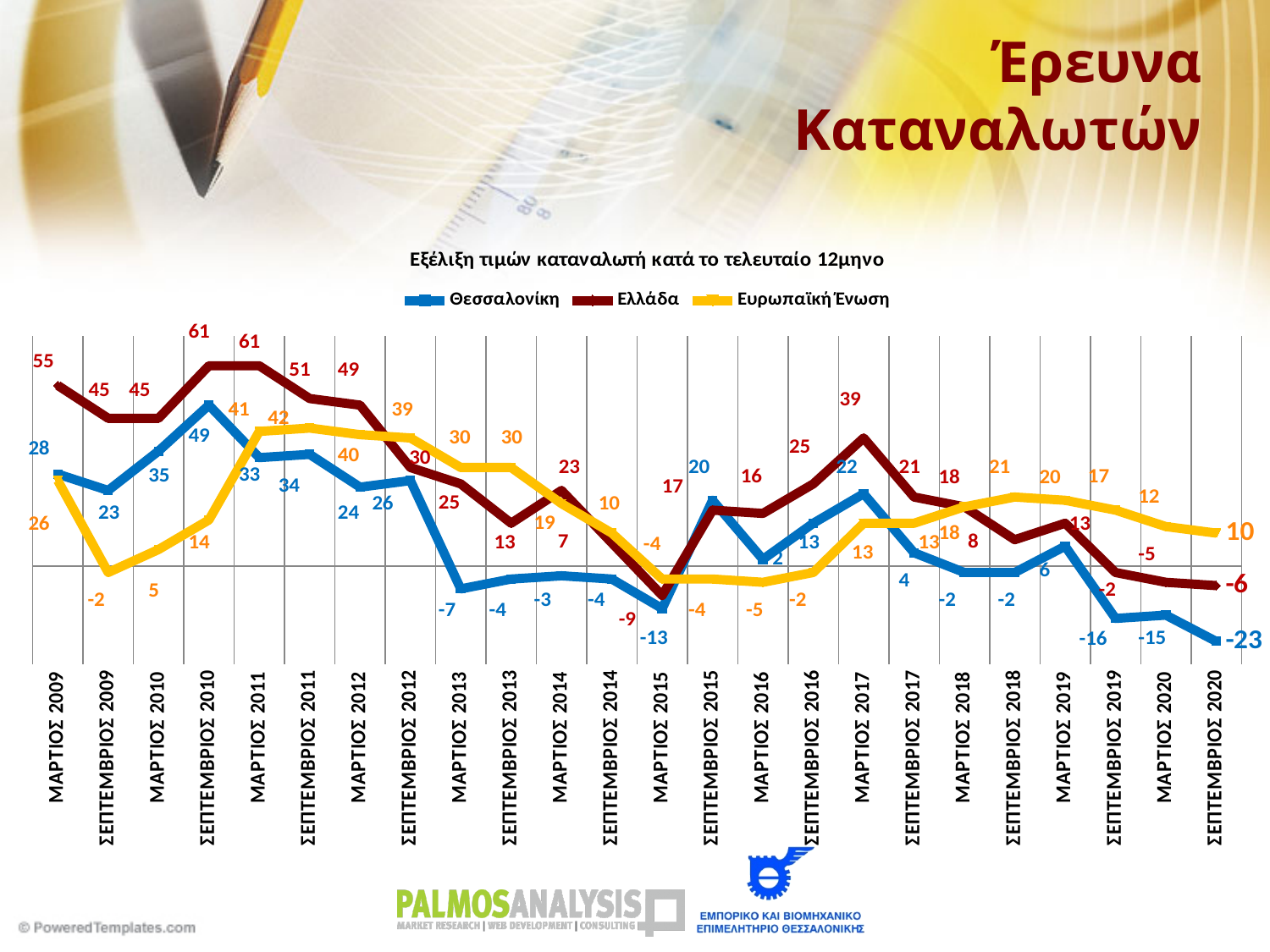
How many series does the legend list? 3 What is the value for Ελλάδα in ΜΑΡΤΙΟΣ 2017? 39 What is the value for Θεσσαλονίκη in ΣΕΠΤΕΜΒΡΙΟΣ 2020? -23 What is the value for Ευρωπαϊκή Ένωση in ΣΕΠΤΕΜΒΡΙΟΣ 2009? -2 Does the Θεσσαλονίκη series rise or fall from ΜΑΡΤΙΟΣ 2019 to ΣΕΠΤΕΜΒΡΙΟΣ 2020? Fall What is the highest value reached by the Ελλάδα series? 61 In ΣΕΠΤΕΜΒΡΙΟΣ 2020, which series has the larger value, Ευρωπαϊκή Ένωση or Ελλάδα? Ευρωπαϊκή Ένωση What kind of chart is shown on the slide? Line chart In which period does the Θεσσαλονίκη series reach its lowest value? ΣΕΠΤΕΜΒΡΙΟΣ 2020 How many time periods are shown on the x axis? 24 What is the title of the chart? Εξέλιξη τιμών καταναλωτή κατά το τελευταίο 12μηνο What is the difference between the Ελλάδα and Θεσσαλονίκη values in ΜΑΡΤΙΟΣ 2017? 17